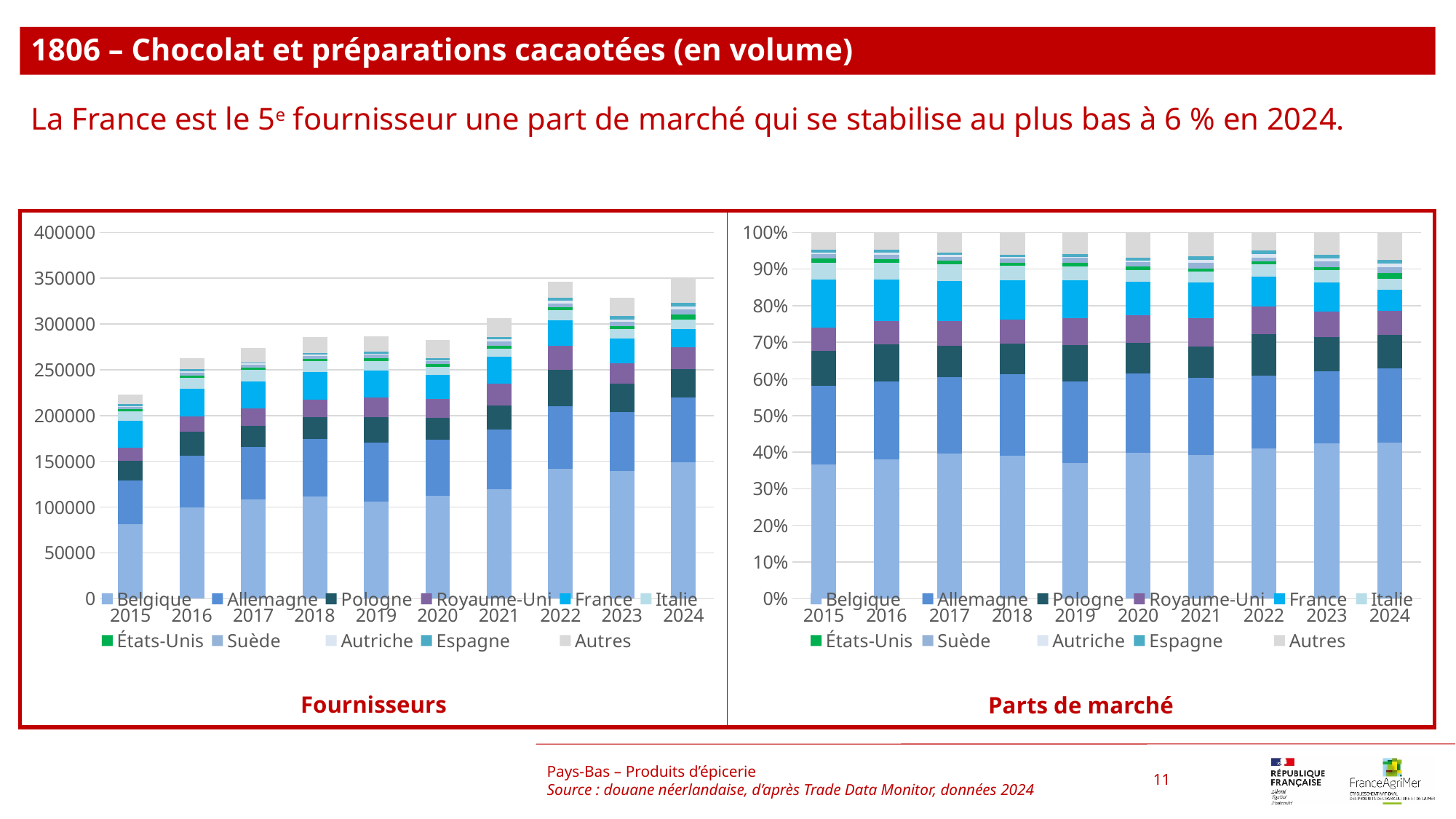
How many series does the legend of the 'Fournisseurs' chart list? 11 How many years are shown on the x axis of the 'Parts de marché' chart? 10 In the 'Fournisseurs' chart, which total stacked bar is larger, 2022 or 2023? 2022 In the 'Fournisseurs' chart, is the total stacked bar for 2015 greater or less than 250000? less In the 'Parts de marché' chart, is the Belgique share for 2015 greater or less than 40%? less What kind of chart is the 'Fournisseurs' chart on the left? stacked bar chart In the 'Fournisseurs' chart, is the total stacked bar for 2022 greater or less than 300000? greater In the 'Fournisseurs' chart, do the total stacked bars generally rise or fall from 2015 to 2024? rise In the 'Fournisseurs' chart, which year has the lowest total stacked bar? 2015 What is the title of the chart on the right of the slide? Parts de marché